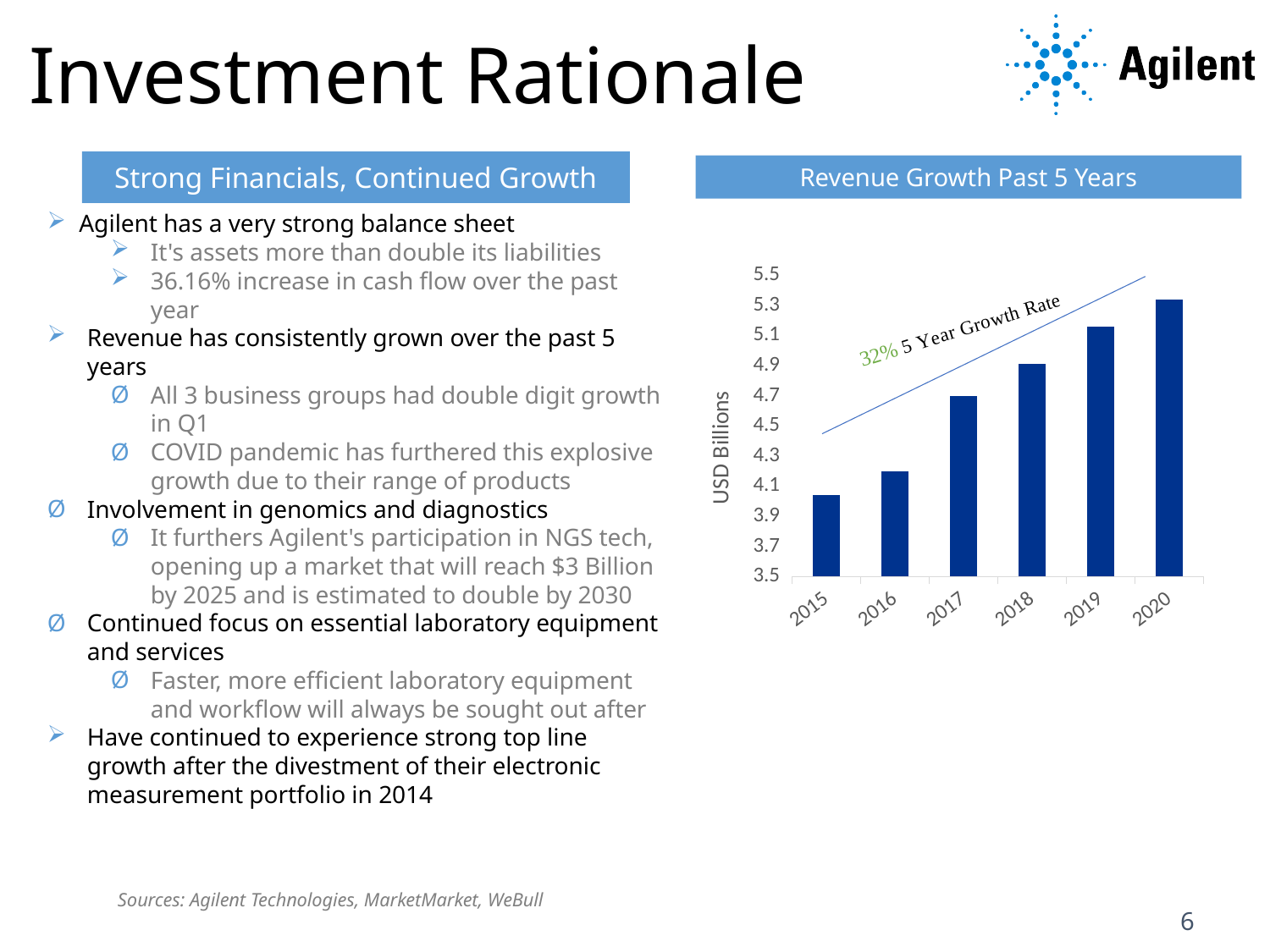
Is the revenue bar for 2015 greater or less than 4.3 USD billions? less Do the revenue bars rise or fall from 2015 to 2020? Rise How many years are plotted on the revenue growth chart? 6 What is the label on the vertical axis of the revenue chart? USD Billions Which year has the highest revenue bar on the chart? 2020 What growth rate is written along the trend line on the revenue chart? 32% 5 Year Growth Rate Which year has a taller revenue bar, 2017 or 2019? 2019 Is the revenue bar for 2016 greater or less than 4.5 USD billions? less Is the revenue bar for 2018 greater or less than 4.7 USD billions? greater What kind of chart is shown under the title "Revenue Growth Past 5 Years"? Bar chart Which year has the lowest revenue bar on the chart? 2015